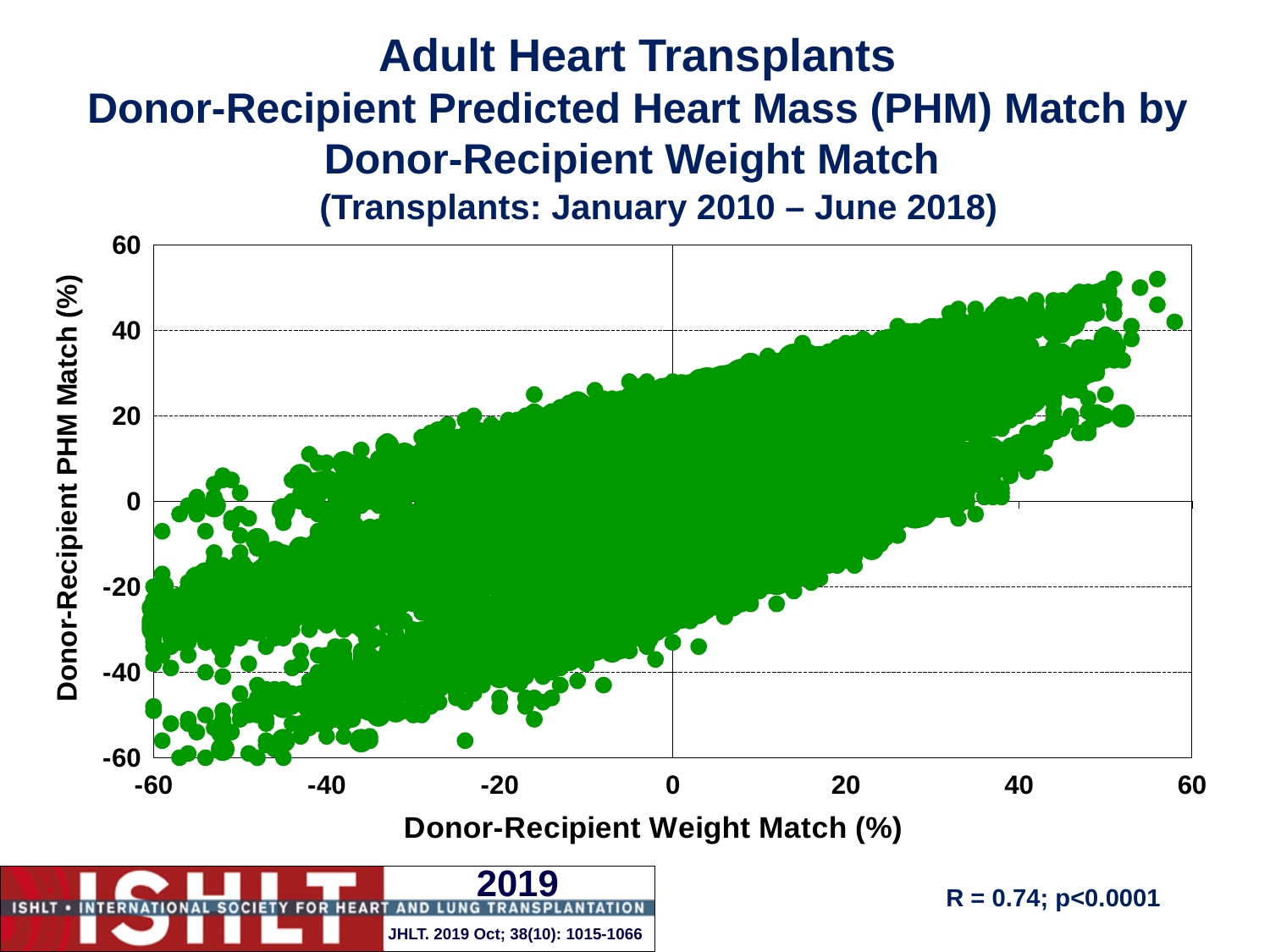
What kind of chart is shown on the slide? scatter plot As Donor-Recipient Weight Match (%) increases along the x axis, does Donor-Recipient PHM Match (%) tend to rise or fall? rise What is the correlation coefficient R reported on the slide? R = 0.74 What time period of transplants does the chart cover, according to the title? January 2010 – June 2018